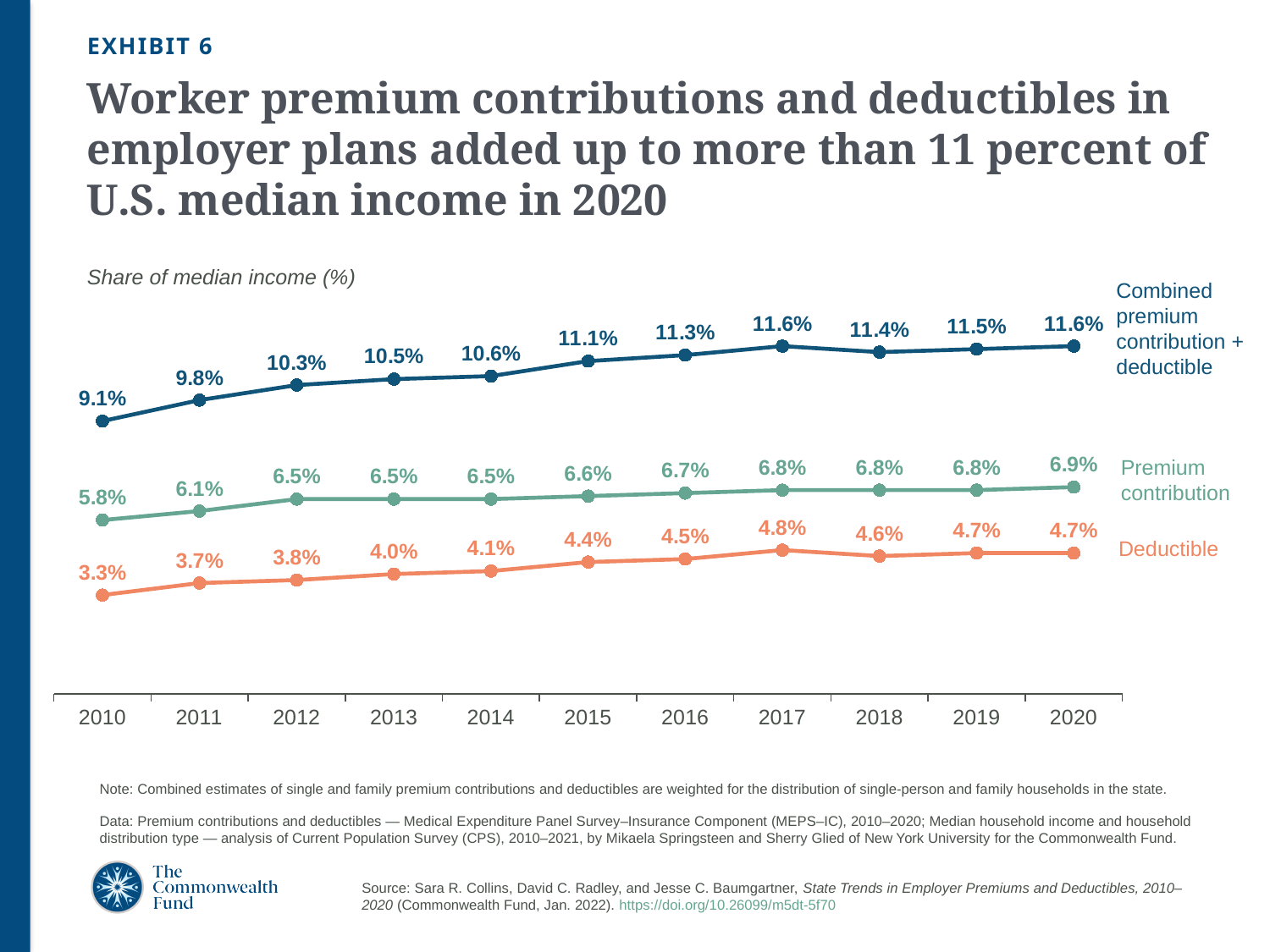
Does the Premium contribution series generally rise or fall from 2010 to 2020? Rise In which year is the Deductible series at its highest? 2017 How many years are shown on the x axis? 11 Which is larger in 2014: Premium contribution or Deductible? Premium contribution What is the value for Deductible in 2010? 3.3% What is the value for Combined premium contribution + deductible in 2020? 11.6% What is the difference between Premium contribution and Deductible in 2017? 2.0% What kind of chart is shown on the slide? Line chart In which year is the Combined premium contribution + deductible series at its lowest? 2010 How many series are plotted on the chart? 3 What is the value for Premium contribution in 2015? 6.6% What is the difference between the Combined premium contribution + deductible values in 2020 and 2010? 2.5%